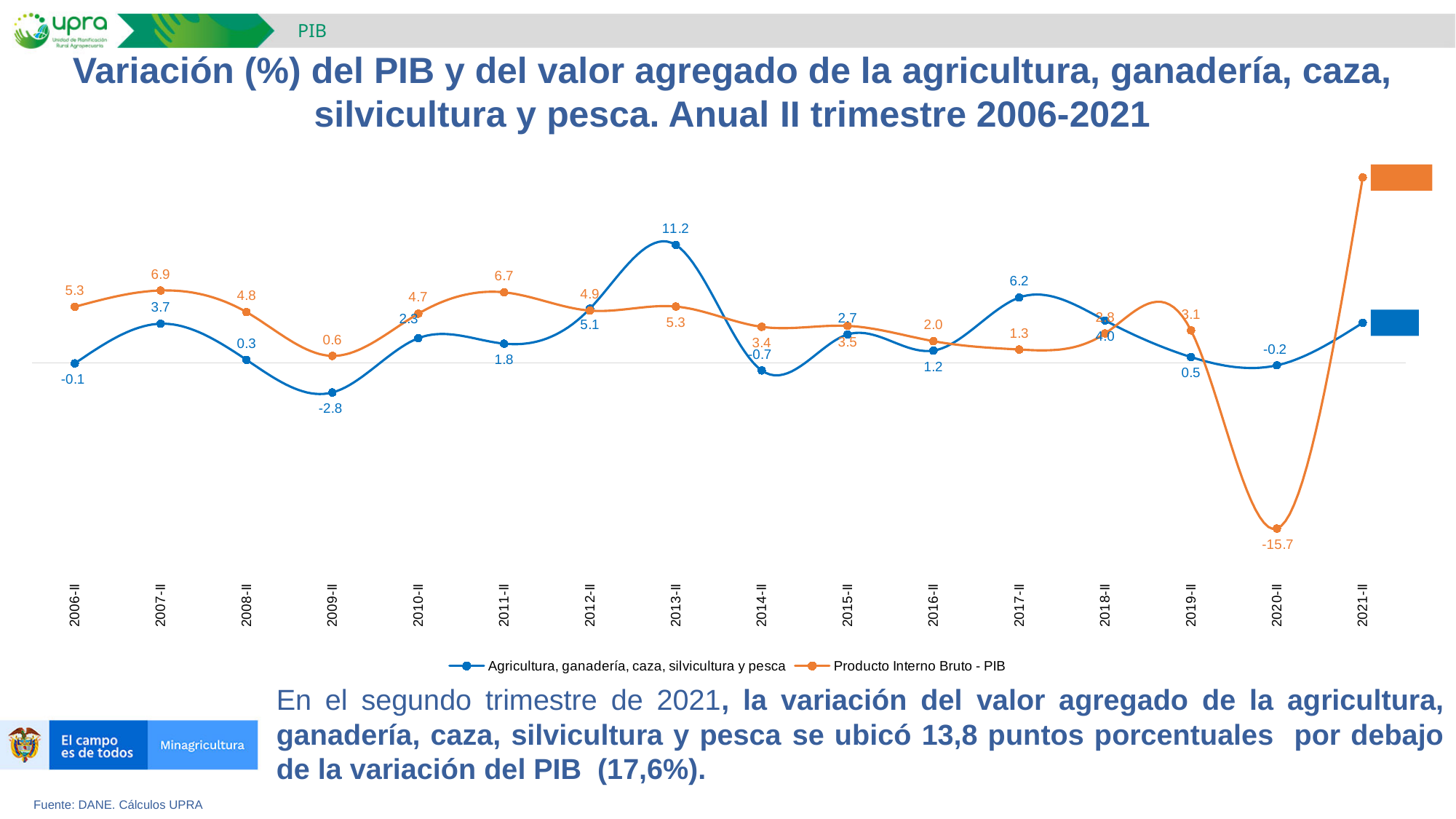
In 2009-II, which series has the higher value: Agricultura, ganadería, caza, silvicultura y pesca or Producto Interno Bruto - PIB? Producto Interno Bruto - PIB What is the value of the Agricultura, ganadería, caza, silvicultura y pesca series for 2009-II? -2.8 What is the value of the Producto Interno Bruto - PIB series for 2007-II? 6.9 In which period does the Agricultura, ganadería, caza, silvicultura y pesca series reach its highest value? 2013-II How many periods are shown on the x axis of the chart? 16 Does the Producto Interno Bruto - PIB series rise or fall from 2017-II to 2018-II? Rise In which period does the Producto Interno Bruto - PIB series reach its lowest value? 2020-II What is the difference between the Agricultura series and the PIB series in 2013-II? 5.9 What is the value of the Agricultura, ganadería, caza, silvicultura y pesca series for 2013-II? 11.2 What kind of chart is shown on the slide? Line chart What is the value of the Producto Interno Bruto - PIB series for 2020-II? -15.7 How many series does the legend list? 2